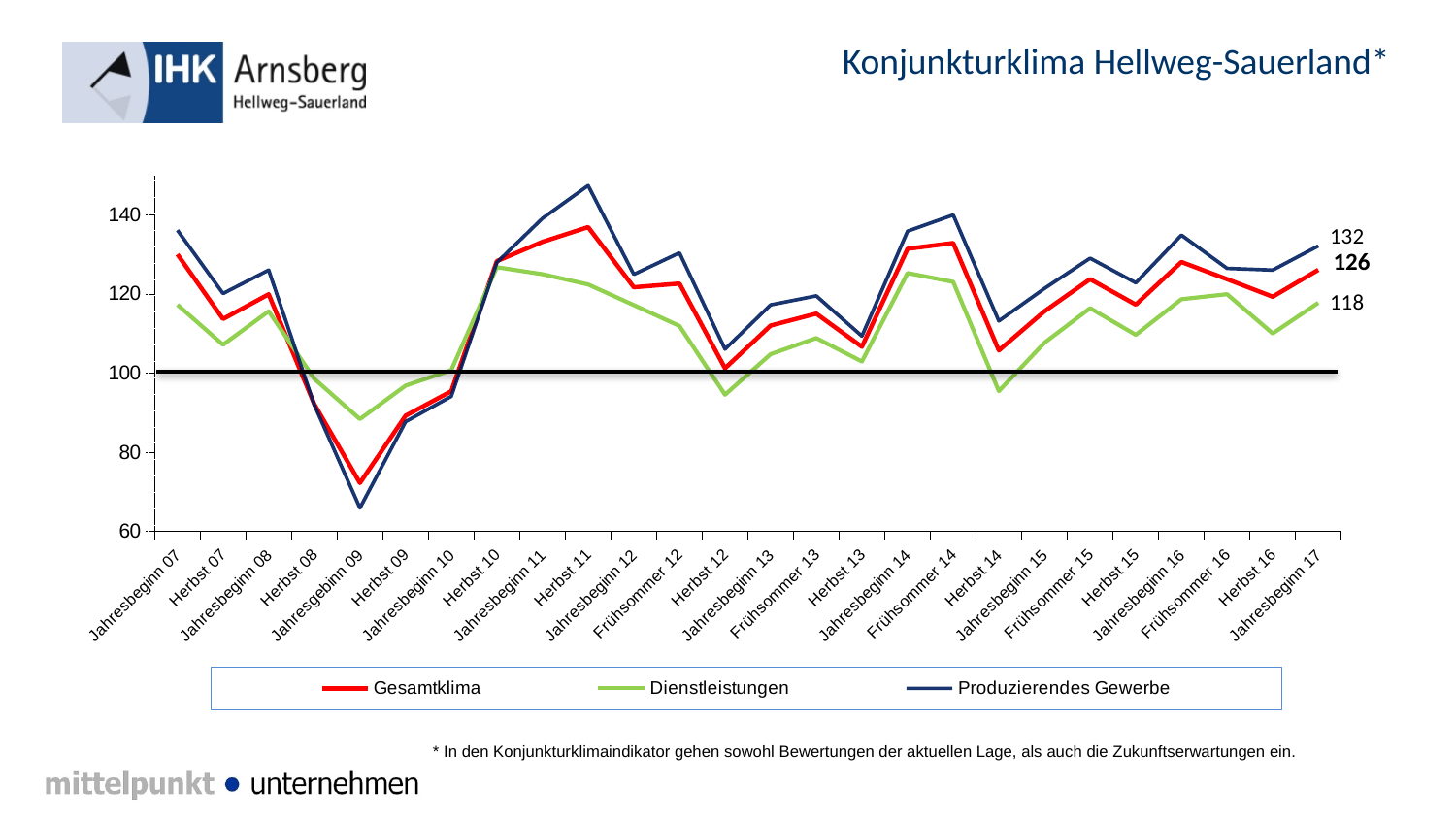
What is the value of Dienstleistungen at Jahresbeginn 17? 118 At Jahresbeginn 17, what is the difference between Produzierendes Gewerbe and Dienstleistungen? 14 What kind of chart is shown on the slide? line chart At Jahresbeginn 17, which is larger: Gesamtklima or Dienstleistungen? Gesamtklima What is the value of Gesamtklima at Jahresbeginn 17? 126 How many series does the legend list? 3 How many periods are shown on the x axis? 26 Is the value for Produzierendes Gewerbe at Herbst 11 greater or less than 140? greater Which series is drawn in red? Gesamtklima Is the value for Gesamtklima at Jahresgebinn 09 greater or less than 80? less At which period does Gesamtklima reach its lowest value? Jahresgebinn 09 What is the value of Produzierendes Gewerbe at Jahresbeginn 17? 132